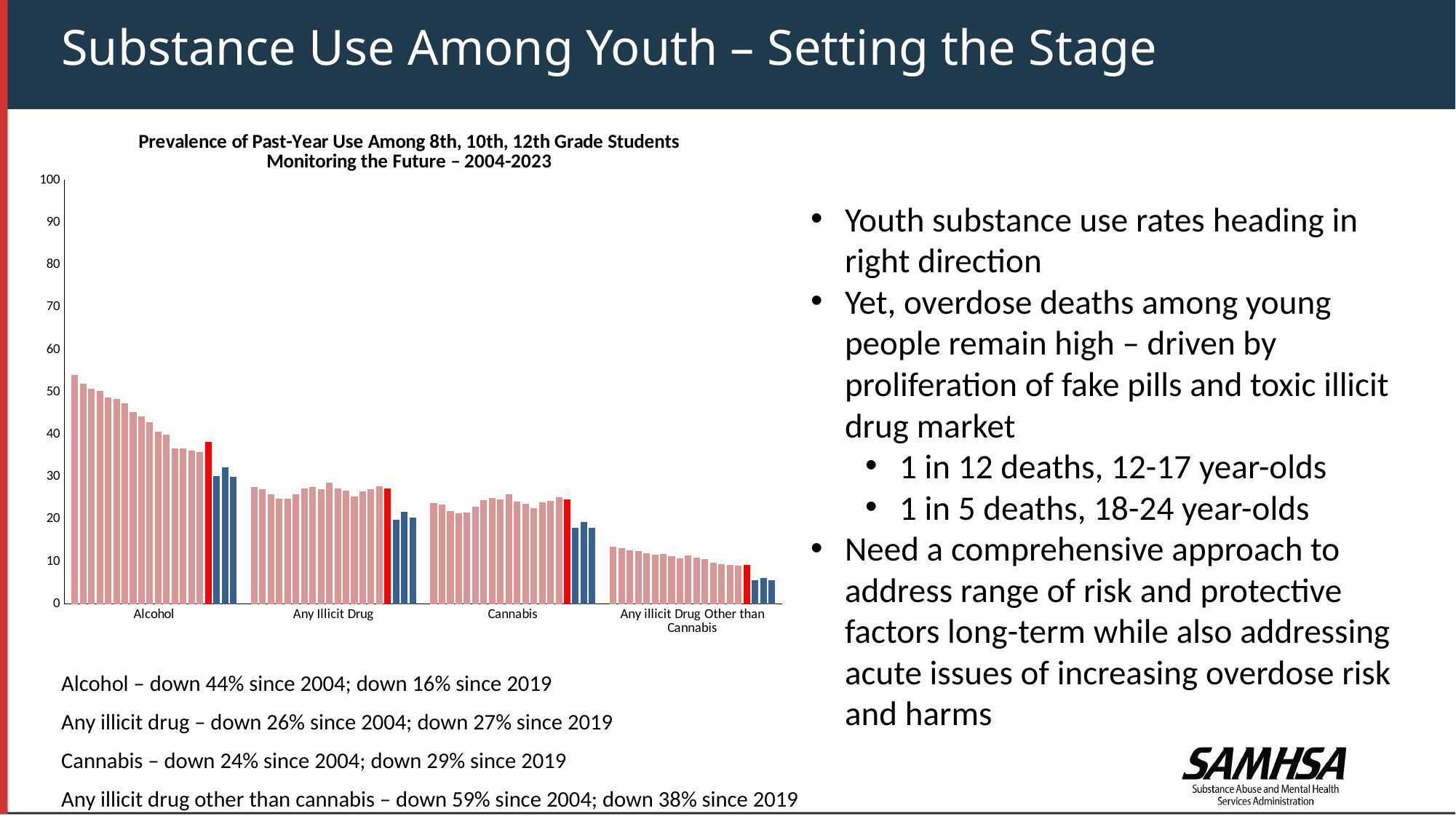
What is the maximum value shown on the chart's y axis? 100 What kind of chart is shown on the slide? bar chart Are all the bars for Any Illicit Drug greater or less than 40? less Which is larger, the first Alcohol bar or the first Cannabis bar? the first Alcohol bar Do the bars for Alcohol rise or fall from left to right across the years? fall Is the value of the first (leftmost) Alcohol bar greater or less than 50? greater Which substance category has the highest bars in the chart? Alcohol Do the bars for Any illicit Drug Other than Cannabis rise or fall from left to right across the years? fall Which substance category has the lowest bars in the chart? Any illicit Drug Other than Cannabis Is the value of the last (rightmost) Any illicit Drug Other than Cannabis bar greater or less than 10? less What is the title of the chart? Prevalence of Past-Year Use Among 8th, 10th, 12th Grade Students Monitoring the Future – 2004-2023 How many substance categories are shown along the x axis of the chart? 4